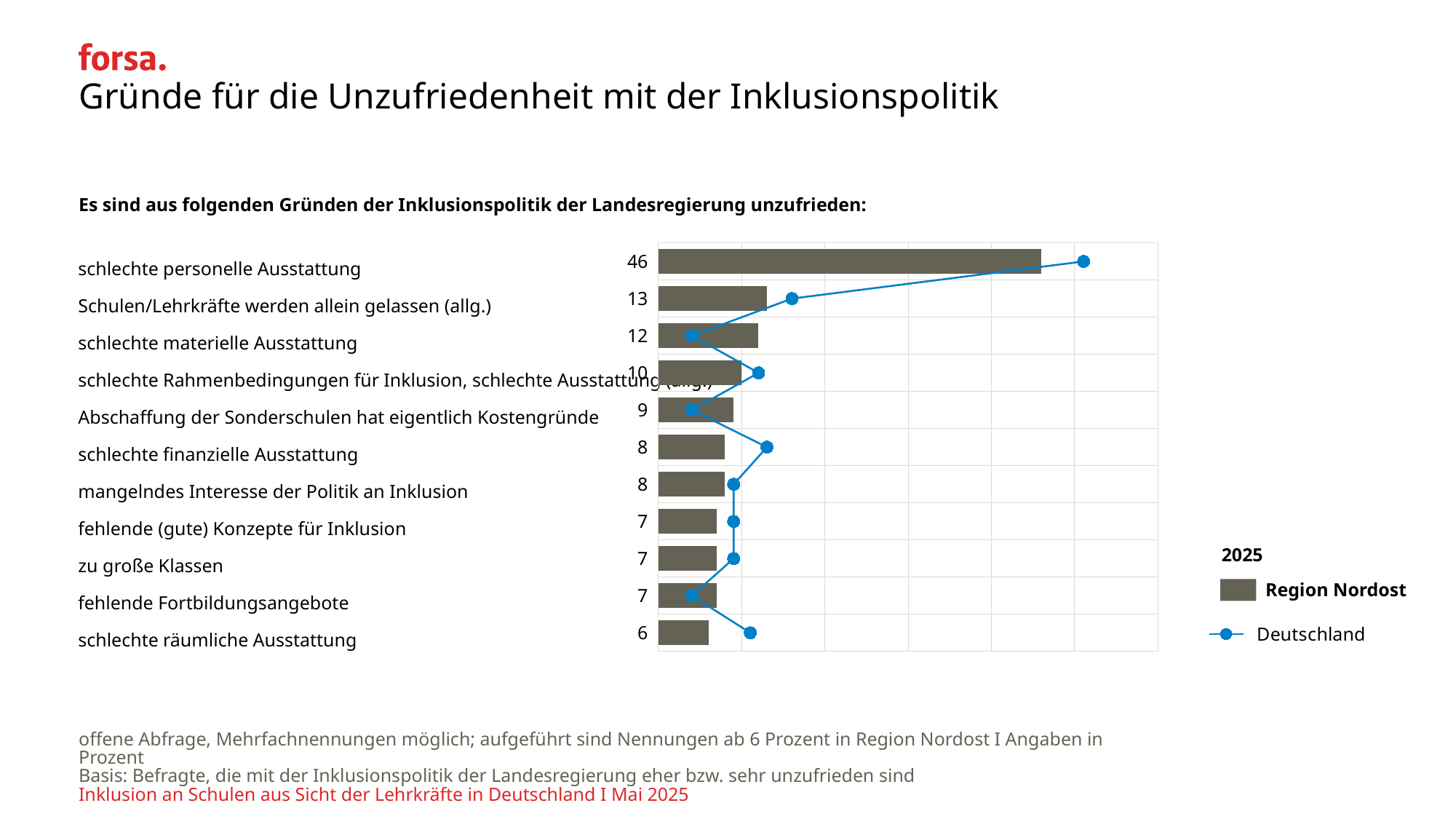
What is the Region Nordost value for "schlechte personelle Ausstattung"? 46 Which reason has the highest Region Nordost value? schlechte personelle Ausstattung Which series is shown as a blue line with markers? Deutschland How many series does the legend list? 2 Which has the larger Region Nordost value: "schlechte materielle Ausstattung" or "schlechte finanzielle Ausstattung"? schlechte materielle Ausstattung What kind of chart is used to show the Region Nordost values? bar chart What is the Region Nordost value for "schlechte räumliche Ausstattung"? 6 How many reasons are listed in the chart? 11 What is the Region Nordost value for "Schulen/Lehrkräfte werden allein gelassen (allg.)"? 13 What is the difference between the Region Nordost values for "schlechte personelle Ausstattung" and "Schulen/Lehrkräfte werden allein gelassen (allg.)"? 33 Which reason has the lowest Region Nordost value? schlechte räumliche Ausstattung What is the Region Nordost value for "schlechte materielle Ausstattung"? 12